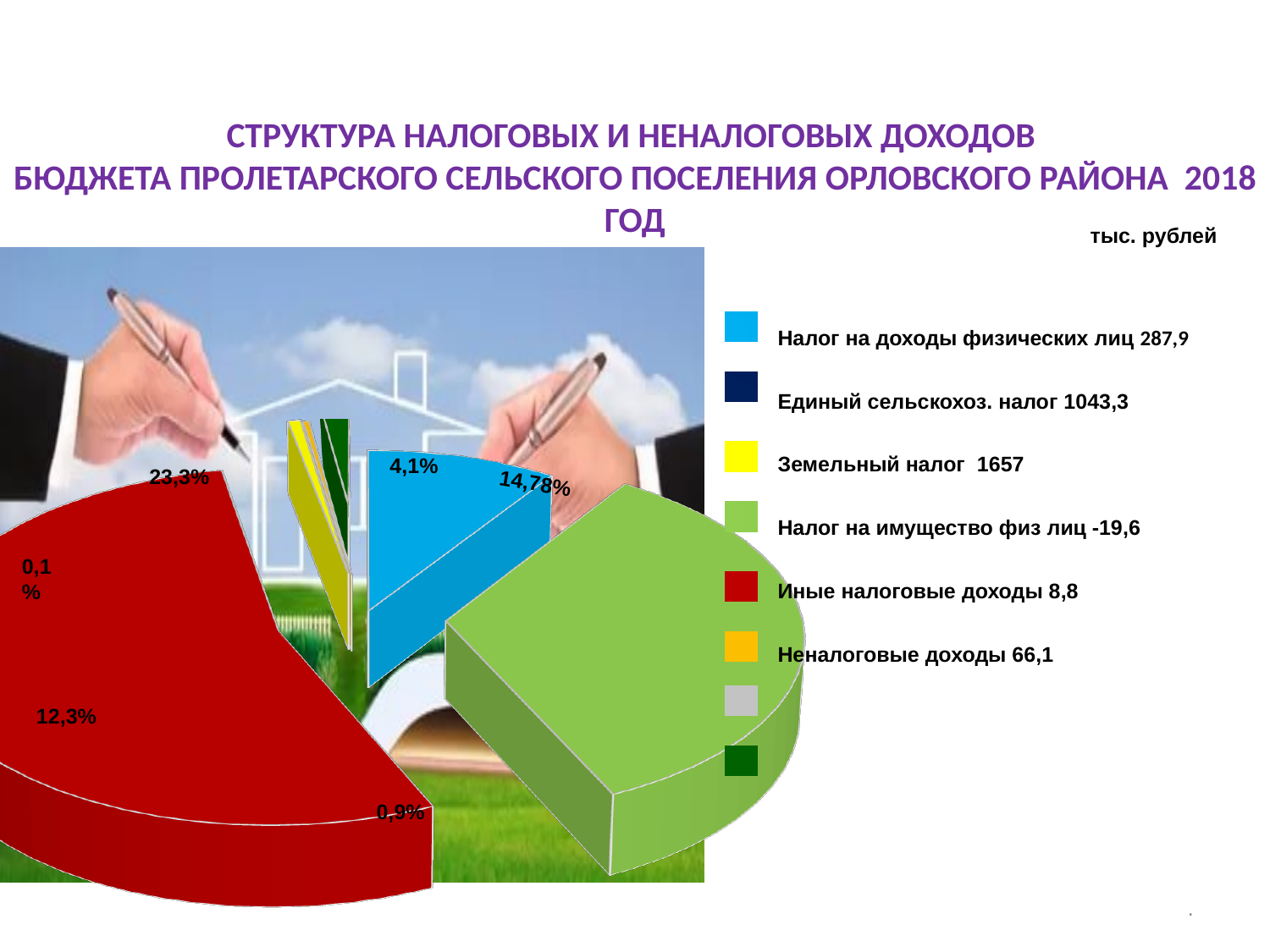
What kind of chart is shown on the slide? pie chart Which legend item has the highest value? Земельный налог In what units are the values on the slide given? тыс. рублей What is the difference between the values for Земельный налог and Единый сельскохоз. налог? 613,7 What value is given in the legend for Иные налоговые доходы? 8,8 What value is given in the legend for Налог на имущество физ лиц? -19,6 Which legend item has the lowest value? Налог на имущество физ лиц What value is given in the legend for Неналоговые доходы? 66,1 Which is larger: Единый сельскохоз. налог or Налог на доходы физических лиц? Единый сельскохоз. налог What value is given in the legend for Налог на доходы физических лиц? 287,9 What value is given in the legend for Земельный налог? 1657 What value is given in the legend for Единый сельскохоз. налог? 1043,3